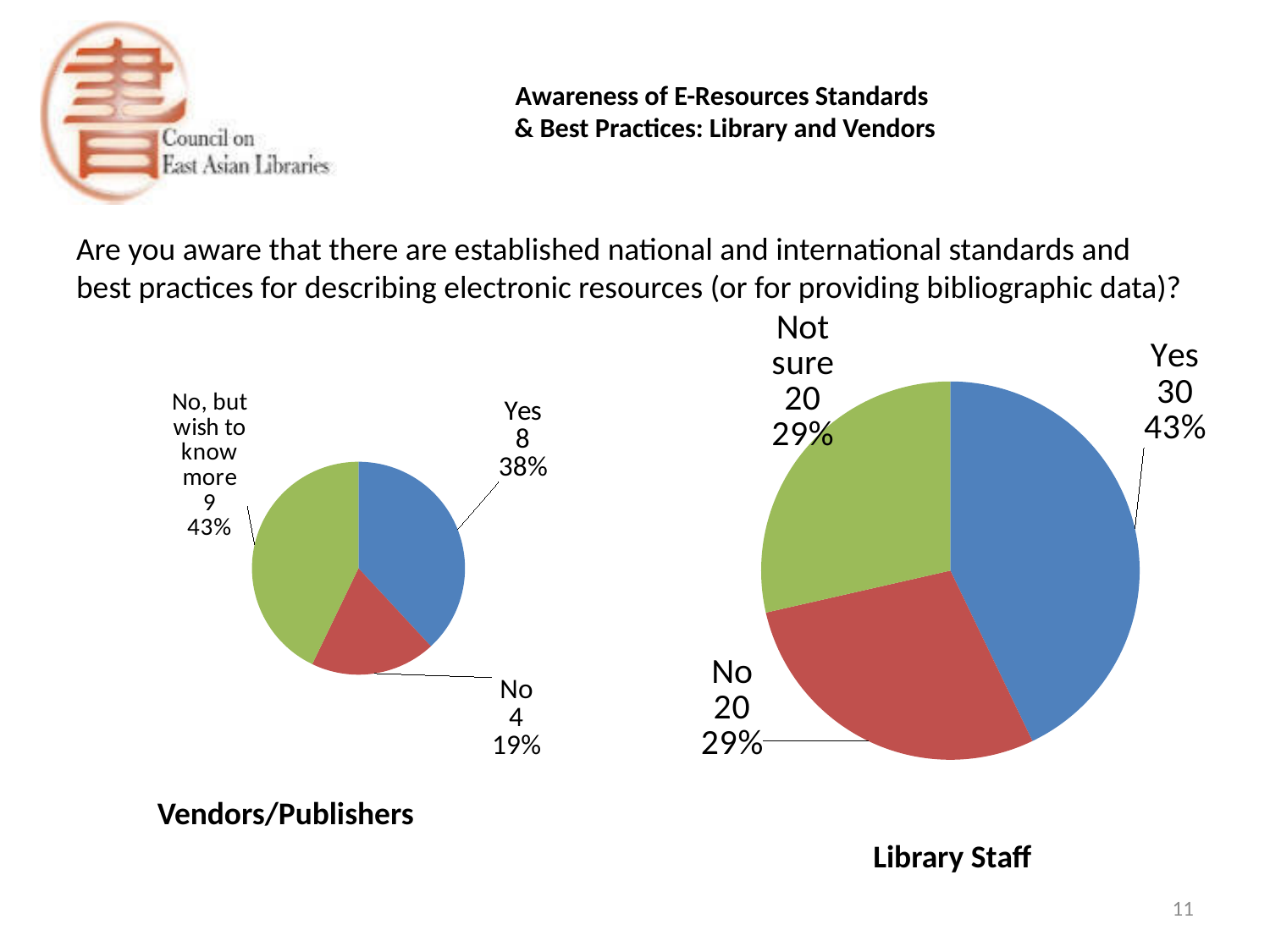
How many slices does the Vendors/Publishers pie chart have? 3 What type of chart is used for the Library Staff data? Pie chart In the Library Staff pie chart, what is the difference between the number of Yes responses and Not sure responses? 10 In the Vendors/Publishers pie chart, what share of the pie does the No slice represent? 19% In the Library Staff pie chart, which response has the largest slice? Yes In the Library Staff pie chart, what percentage of respondents answered Yes? 43% In the Vendors/Publishers pie chart, which response has the smallest slice? No In the Vendors/Publishers pie chart, how many respondents answered Yes? 8 Which chart has more Yes responses, Vendors/Publishers or Library Staff? Library Staff In the Vendors/Publishers pie chart, which response has the largest slice? No, but wish to know more In the Library Staff pie chart, how many respondents answered Not sure? 20 In the Vendors/Publishers pie chart, what is the difference between the number of Yes responses and No responses? 4